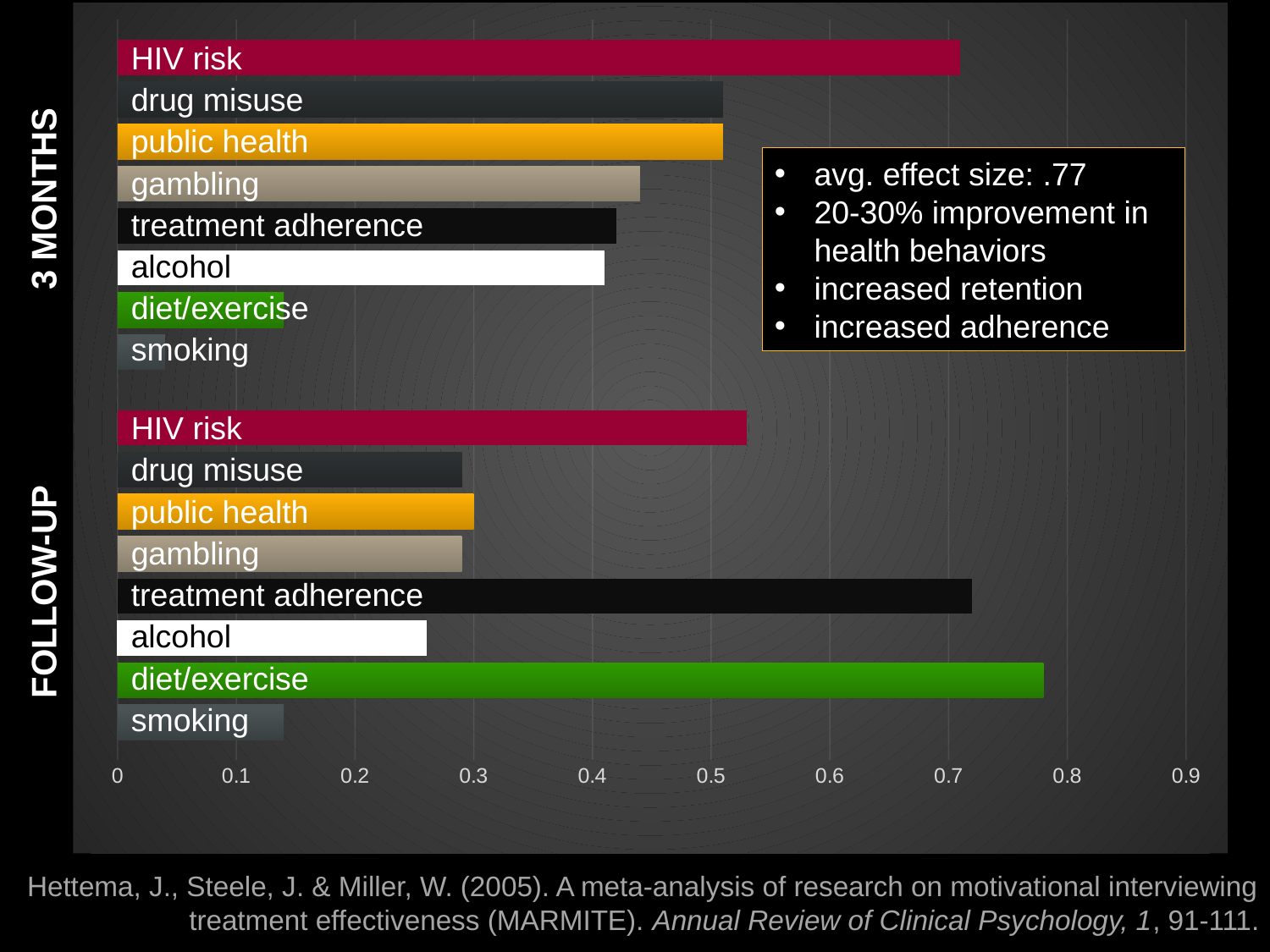
Which category has the longest bar in the FOLLOW-UP group? diet/exercise Which category has the shortest bar in the 3 MONTHS group? smoking Is the value for treatment adherence in the FOLLOW-UP group greater or less than 0.6? greater Is the value for HIV risk in the 3 MONTHS group greater or less than 0.6? greater How many categories are shown in the 3 MONTHS group? 8 According to the text box on the chart, what is the average effect size? .77 Is the value for alcohol in the FOLLOW-UP group greater or less than 0.3? less Which category has the longest bar in the 3 MONTHS group? HIV risk Which is larger: diet/exercise at 3 MONTHS or diet/exercise at FOLLOW-UP? diet/exercise at FOLLOW-UP Which category has the shortest bar in the FOLLOW-UP group? smoking What kind of chart is shown on the slide? bar chart Which is larger: HIV risk at 3 MONTHS or HIV risk at FOLLOW-UP? HIV risk at 3 MONTHS